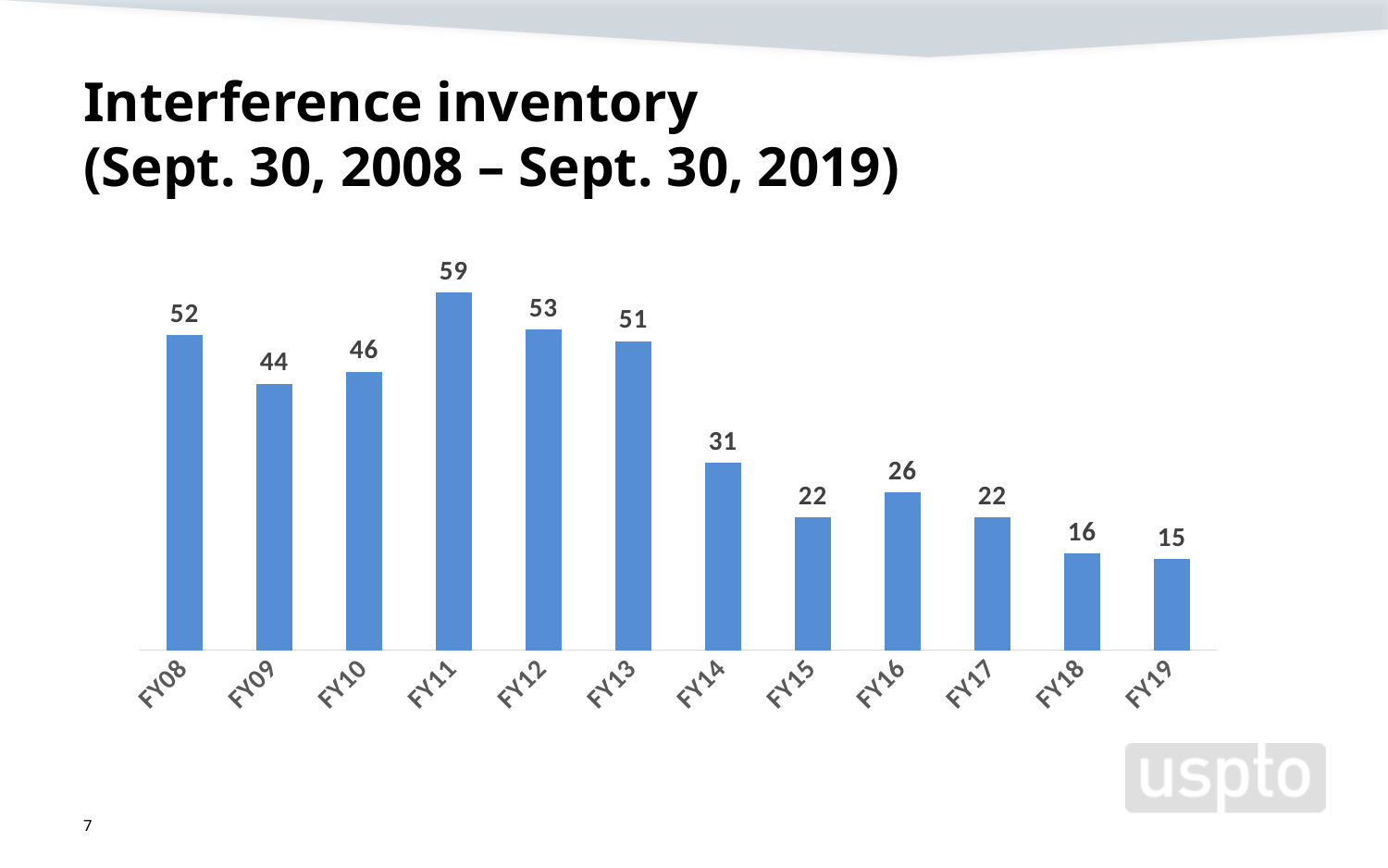
Which fiscal year has the lowest interference inventory? FY19 What is the title of the chart on the slide? Interference inventory (Sept. 30, 2008 – Sept. 30, 2019) What is the difference between the FY08 and FY09 values? 8 What kind of chart is shown on the slide? Bar chart Which is larger, the value for FY12 or the value for FY13? FY12 Do the values generally rise or fall from FY13 to FY19? Fall How many fiscal years are shown on the chart? 12 Which fiscal year has the highest interference inventory? FY11 What is the interference inventory value for FY19? 15 What is the difference between the FY11 and FY19 values? 44 What is the interference inventory value for FY14? 31 What is the interference inventory value for FY11? 59